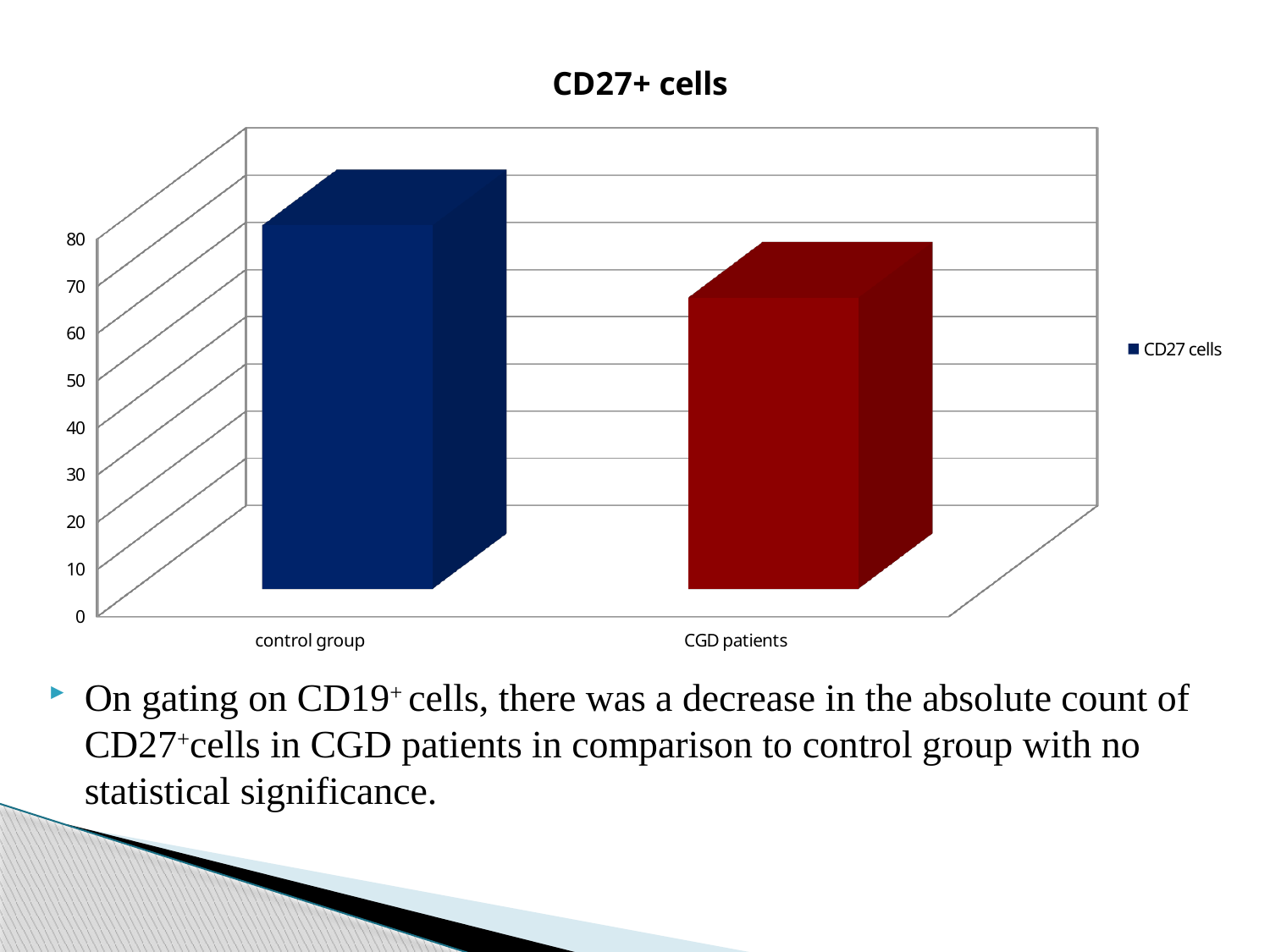
What colour is the bar for CGD patients? red Which is larger, the value for control group or the value for CGD patients? control group Which category has the lowest value in the chart? CGD patients How many series does the legend list? 1 Is the value for control group greater or less than 60? greater Which category has the highest value in the chart? control group Is the value for CGD patients greater or less than 40? greater What is the title of the chart? CD27+ cells Is the value for CGD patients greater or less than 80? less How many categories are shown on the x axis of the chart? 2 What type of chart is shown on the slide? bar chart